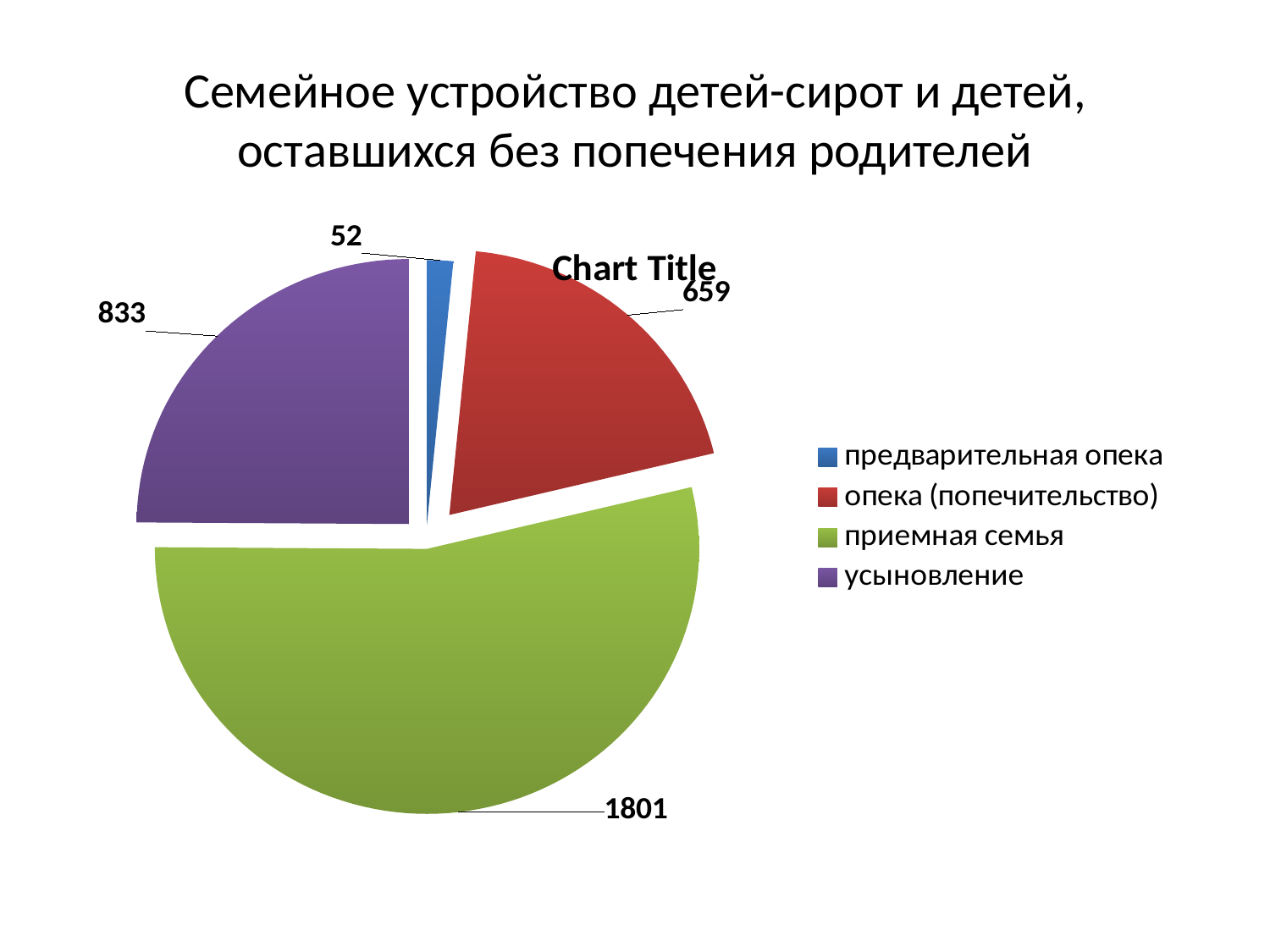
What colour is the slice for приемная семья? green What is the value for усыновление? 833 What is the difference between the values for приемная семья and усыновление? 968 What is the value for опека (попечительство)? 659 What is the value for предварительная опека? 52 How many categories does the legend list? 4 Which category has the smallest slice of the pie? предварительная опека Which category has the largest slice of the pie? приемная семья What is the value for приемная семья? 1801 What is the difference between the values for усыновление and опека (попечительство)? 174 Which is larger, the value for усыновление or the value for опека (попечительство)? усыновление What kind of chart is shown on the slide? pie chart